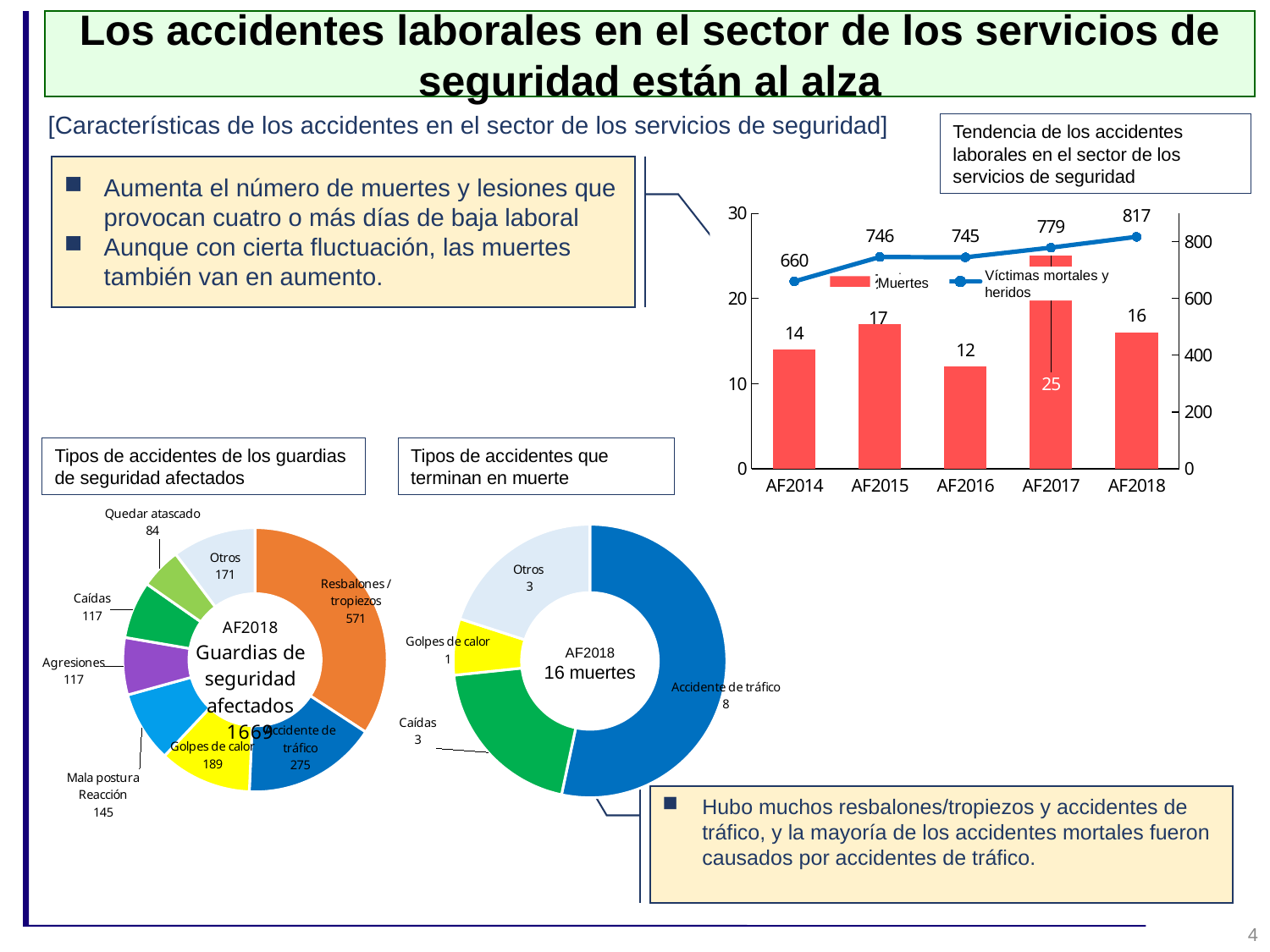
In the chart 'Tipos de accidentes que terminan en muerte', what share of the 16 deaths is Accidente de tráfico? 50% In the chart 'Tendencia de los accidentes laborales en el sector de los servicios de seguridad', what is the value of Muertes for AF2017? 25 How many categories are shown in the chart 'Tipos de accidentes que terminan en muerte'? 4 In the chart 'Tendencia de los accidentes laborales en el sector de los servicios de seguridad', which year has the highest number of Muertes? AF2017 How many series does the legend of the chart 'Tendencia de los accidentes laborales en el sector de los servicios de seguridad' list? 2 In the chart 'Tipos de accidentes de los guardias de seguridad afectados', what is the value for Resbalones / tropiezos? 571 In the chart 'Tendencia de los accidentes laborales en el sector de los servicios de seguridad', by how much did Víctimas mortales y heridos increase from AF2014 to AF2018? 157 In the chart 'Tipos de accidentes de los guardias de seguridad afectados', which category has the largest value? Resbalones / tropiezos What kind of chart is 'Tendencia de los accidentes laborales en el sector de los servicios de seguridad'? Combined bar and line chart In the chart 'Tendencia de los accidentes laborales en el sector de los servicios de seguridad', what is the value of Víctimas mortales y heridos for AF2018? 817 In the chart 'Tendencia de los accidentes laborales en el sector de los servicios de seguridad', does the Víctimas mortales y heridos line rise or fall from AF2014 to AF2018? rises In the chart 'Tendencia de los accidentes laborales en el sector de los servicios de seguridad', which year has the lowest number of Muertes? AF2016